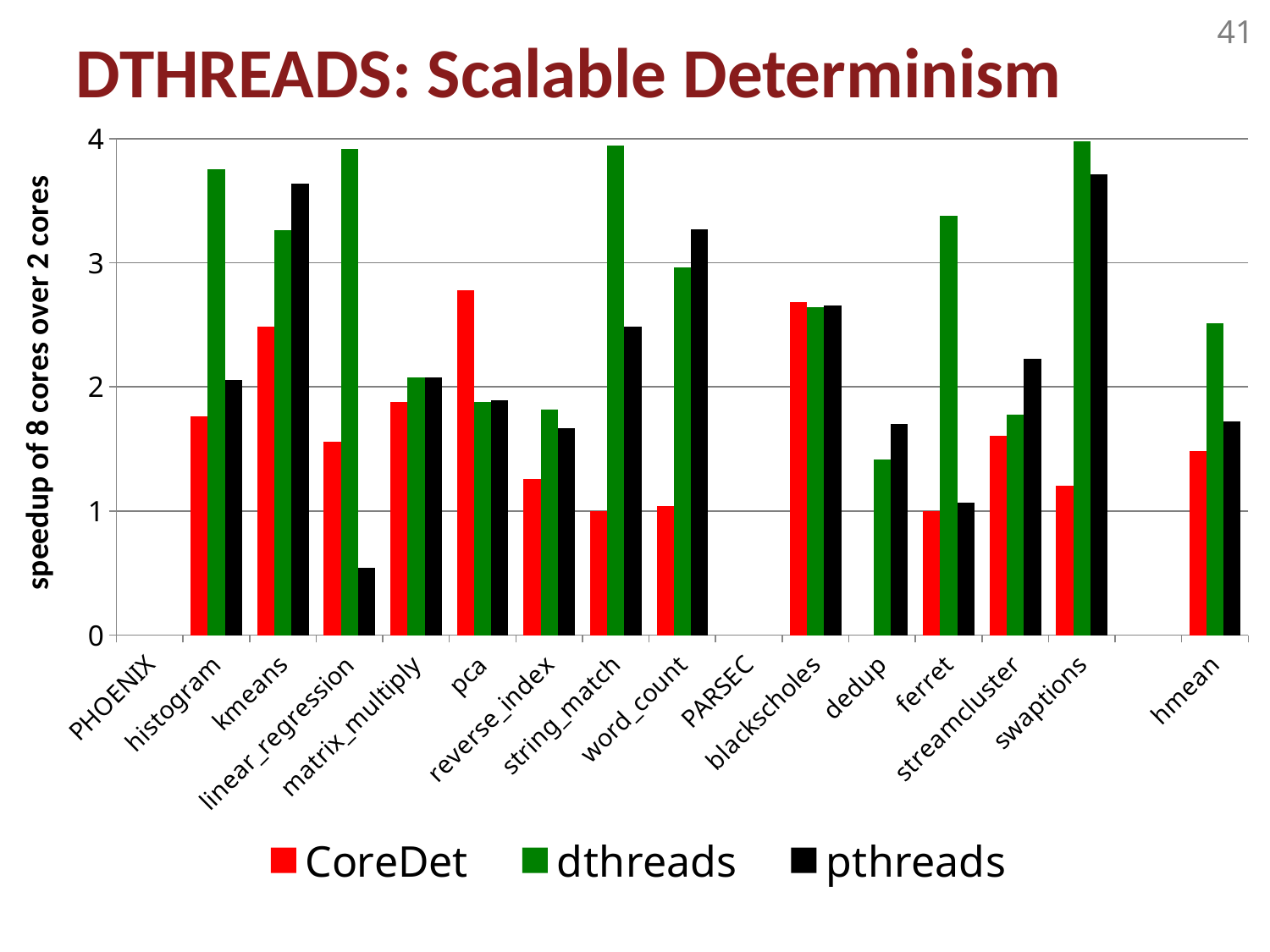
Which category has the lowest pthreads value? linear_regression Is the CoreDet value for pca greater or less than 2? greater For linear_regression, which is larger: the dthreads value or the pthreads value? dthreads What is the label on the y axis? speedup of 8 cores over 2 cores How many series does the legend list? 3 Which colour represents the dthreads series in the legend? green Is the dthreads value for dedup greater or less than 2? less Is the pthreads value for word_count greater or less than 3? greater For pca, which is larger: the CoreDet value or the dthreads value? CoreDet What kind of chart is shown on the slide? bar chart